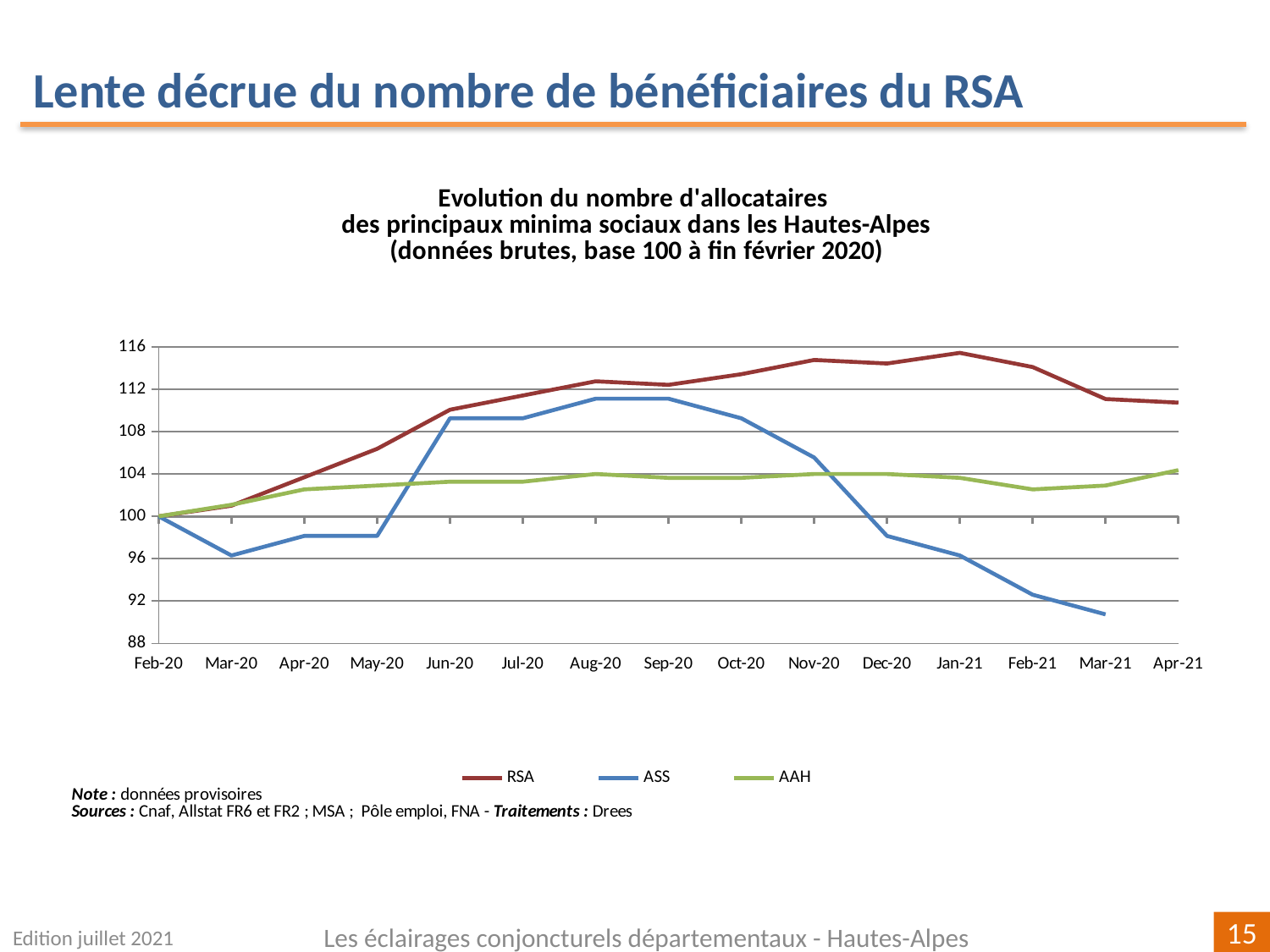
Is the value for RSA at Jan-21 greater or less than 112? greater What kind of chart is shown on the slide? line chart Is the value for ASS at Mar-21 greater or less than 92? less Is the value for AAH at Feb-21 greater or less than 104? less Which series has the highest value at Jan-21? RSA Does the ASS series rise or fall between Nov-20 and Mar-21? fall How many series does the legend list? 3 How many months are plotted along the x axis? 15 What is the value of the RSA series at Feb-20? 100 Which series has the lowest value at Mar-21? ASS At Dec-20, which is larger, the RSA value or the ASS value? RSA